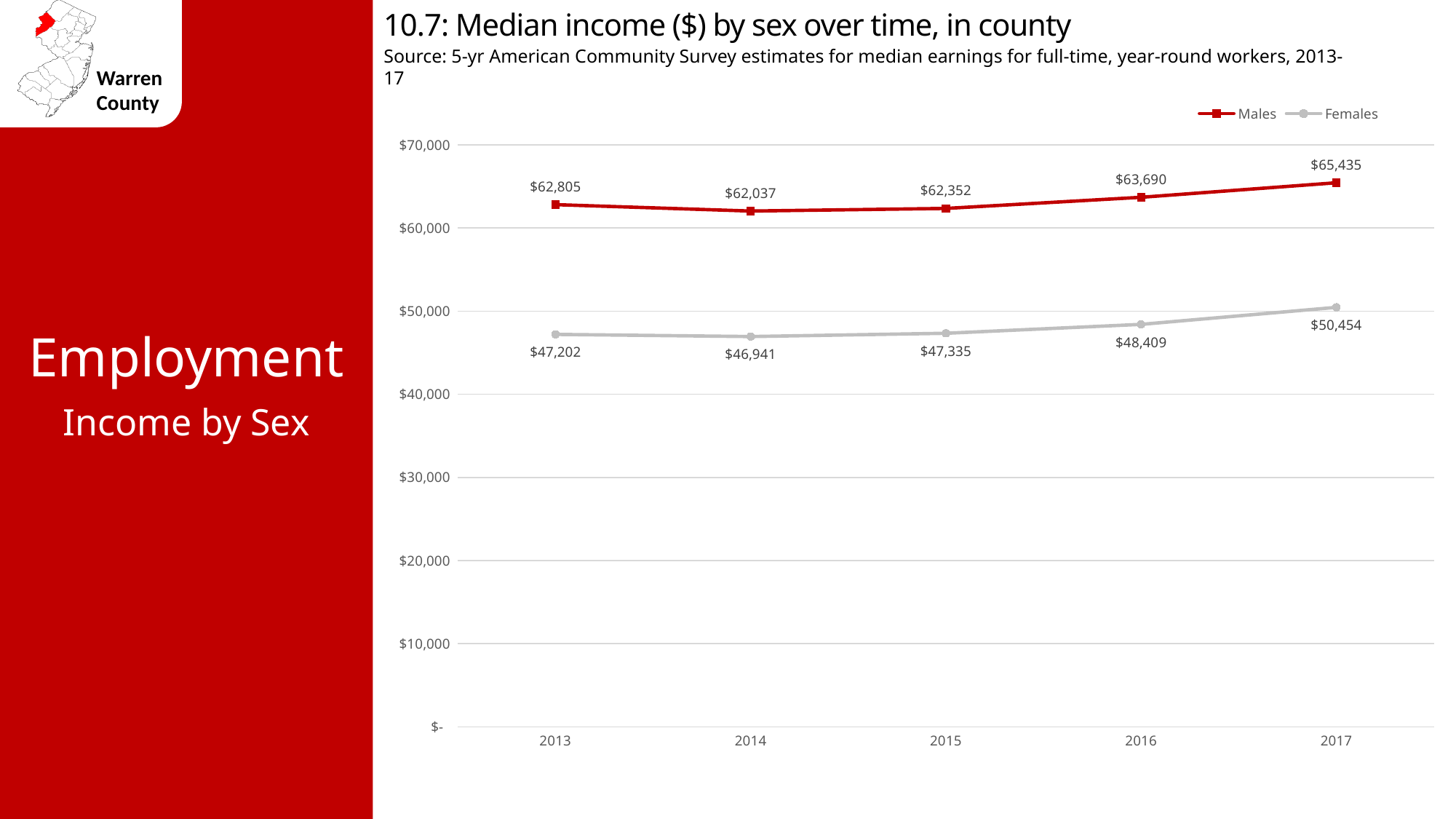
How many years are shown on the x axis? 5 How many series does the legend list? 2 Which is larger, the Females median income in 2016 or in 2013? 2016 In which year is the median income for Females lowest? 2014 Is the median income for Females in 2017 greater or less than $50,000? greater What is the difference between the Males median income in 2016 and in 2013? $885 What is the median income for Females in 2017? $50,454 What kind of chart is shown on the slide? line chart What is the difference between the Males and Females median income in 2017? $14,981 What is the median income for Males in 2015? $62,352 In which year is the median income for Males highest? 2017 What is the median income for Females in 2014? $46,941